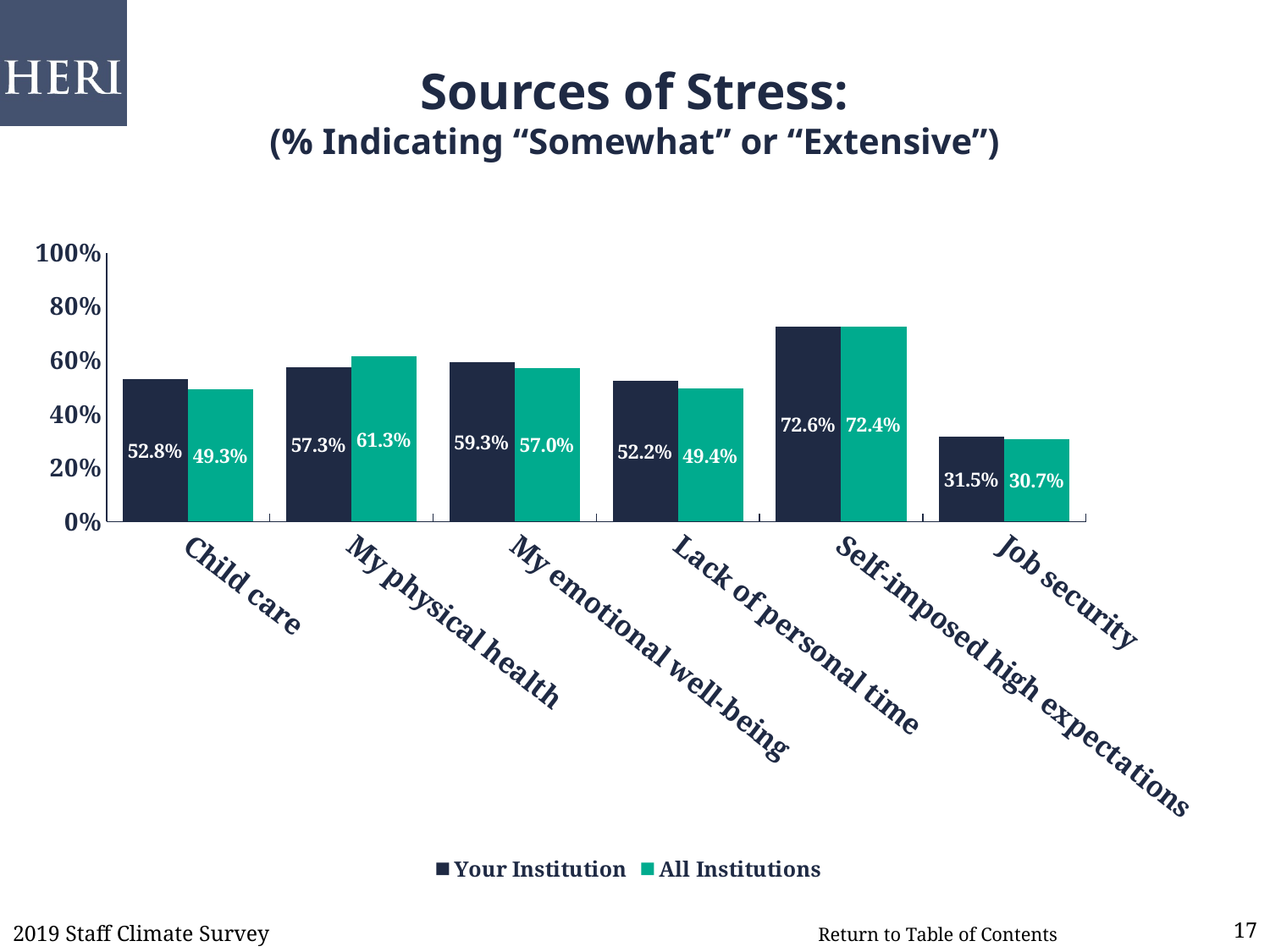
What is the value for All Institutions for My physical health? 61.3% What is the value for Your Institution for Self-imposed high expectations? 72.6% Which is larger for Lack of personal time: Your Institution or All Institutions? Your Institution How many categories are shown on the x axis? 6 What is the difference between Your Institution and All Institutions for My physical health? 4.0% What kind of chart is shown on the slide? Bar chart How many series does the legend list? 2 What is the value for Your Institution for Child care? 52.8% Which category has the highest value for Your Institution? Self-imposed high expectations Which category has the lowest value for All Institutions? Job security Is the value for Your Institution for My emotional well-being greater or less than 40%? greater What is the value for All Institutions for Job security? 30.7%